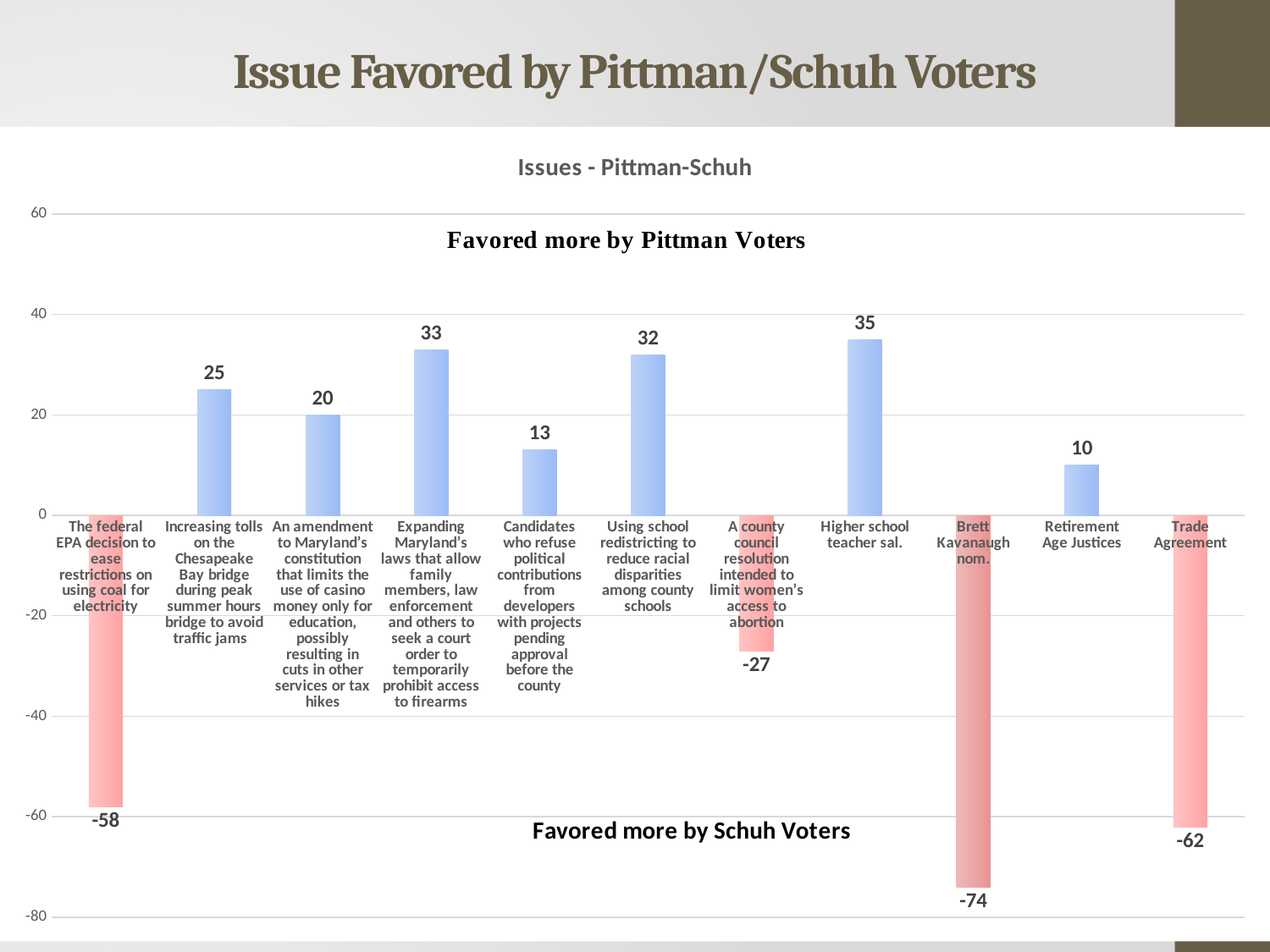
What is the title of the chart? Issues - Pittman-Schuh Which issue has the lowest value on the chart? Brett Kavanaugh nom. Which has a larger value: "Using school redistricting to reduce racial disparities among county schools" or "Candidates who refuse political contributions from developers with projects pending approval before the county"? Using school redistricting to reduce racial disparities among county schools What is the value for "Brett Kavanaugh nom."? -74 What is the value for "Higher school teacher sal."? 35 How many issues (categories) are plotted on the chart? 11 What is the difference between the value for "Higher school teacher sal." and the value for "Retirement Age Justices"? 25 What is the value for "Trade Agreement"? -62 What is the value for "Retirement Age Justices"? 10 What kind of chart is shown on the slide? Bar chart Which issue has the highest value on the chart? Higher school teacher sal. What label is shown in the negative region of the chart, below the zero line? Favored more by Schuh Voters